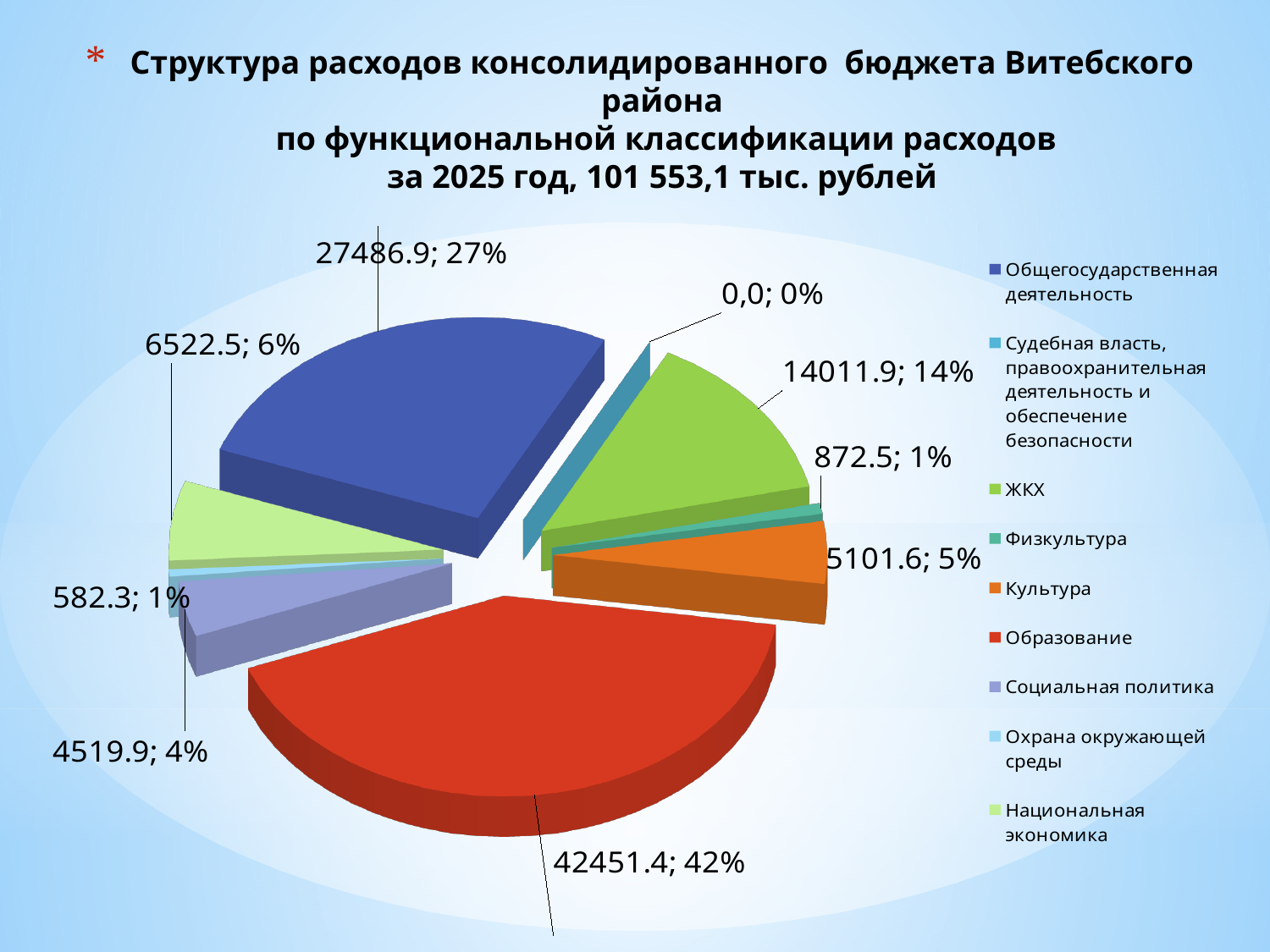
What kind of chart is shown on the slide? pie chart What is the value shown for Образование? 42451.4 Which category has the smallest slice of the pie? Судебная власть, правоохранительная деятельность и обеспечение безопасности How many categories does the legend of the pie chart list? 9 What total amount is stated in the chart title for 2025? 101 553,1 тыс. рублей What is the value shown for ЖКХ? 14011.9 Which category has the largest slice of the pie? Образование Which is larger, the value for Культура or the value for Социальная политика? Культура What is the value shown for Национальная экономика? 6522.5 What is the difference between the values for Общегосударственная деятельность and ЖКХ? 13475.0 What share of the pie does Общегосударственная деятельность take? 27% What share of the pie does Образование take? 42%